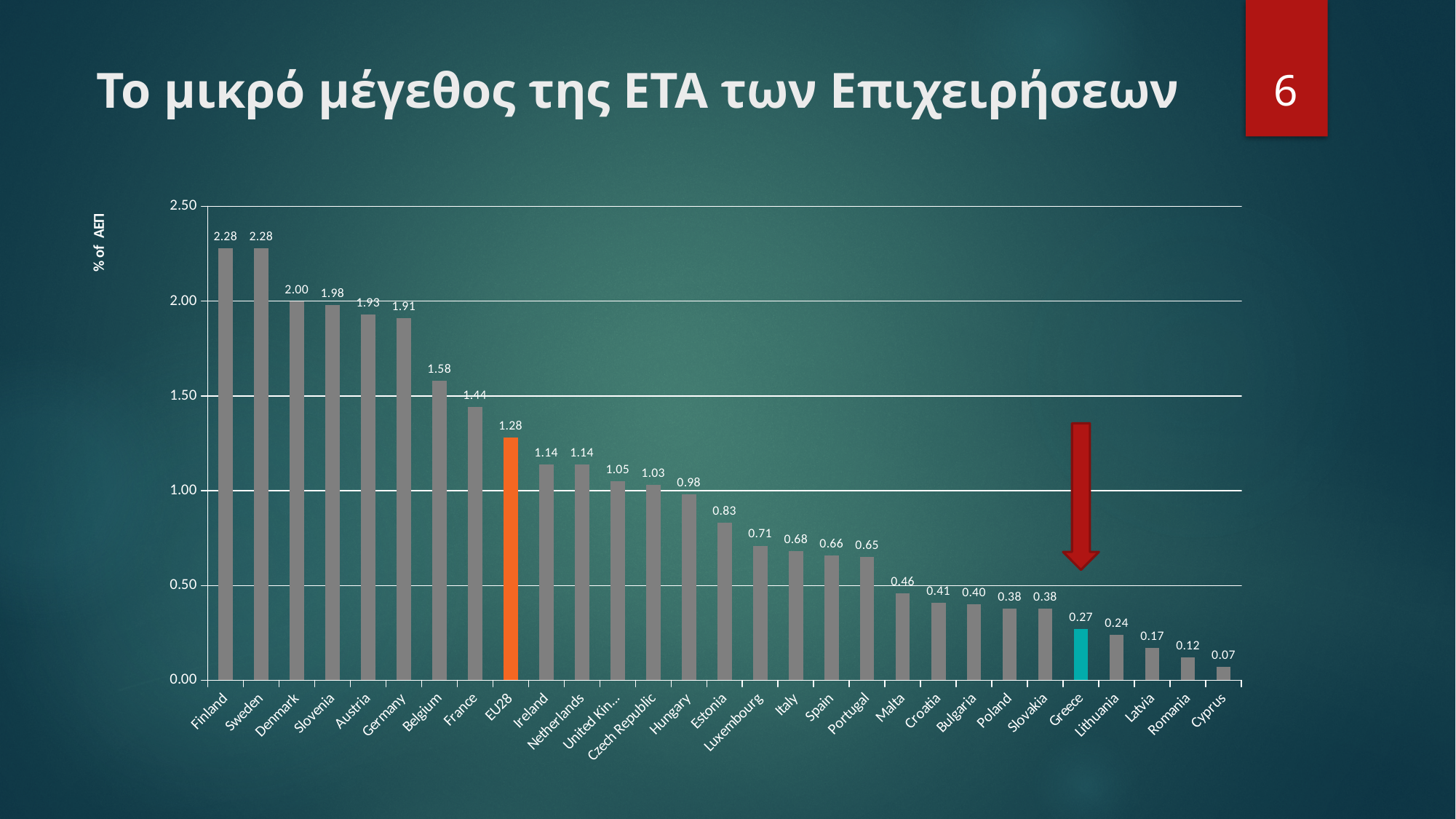
What is the difference between the values for EU28 and Greece? 1.01 What is the label on the vertical axis? % of ΑΕΠ What is the value for Greece? 0.27 What is the value for Czech Republic? 1.03 What is the value for EU28? 1.28 Is the value for Estonia greater or less than 1.00? less What is the difference between the values for Finland and Denmark? 0.28 What kind of chart is shown on the slide? bar chart Which category has the lowest value? Cyprus How many categories are shown on the x axis? 29 Which is larger, the value for Belgium or the value for France? Belgium What is the value for Germany? 1.91